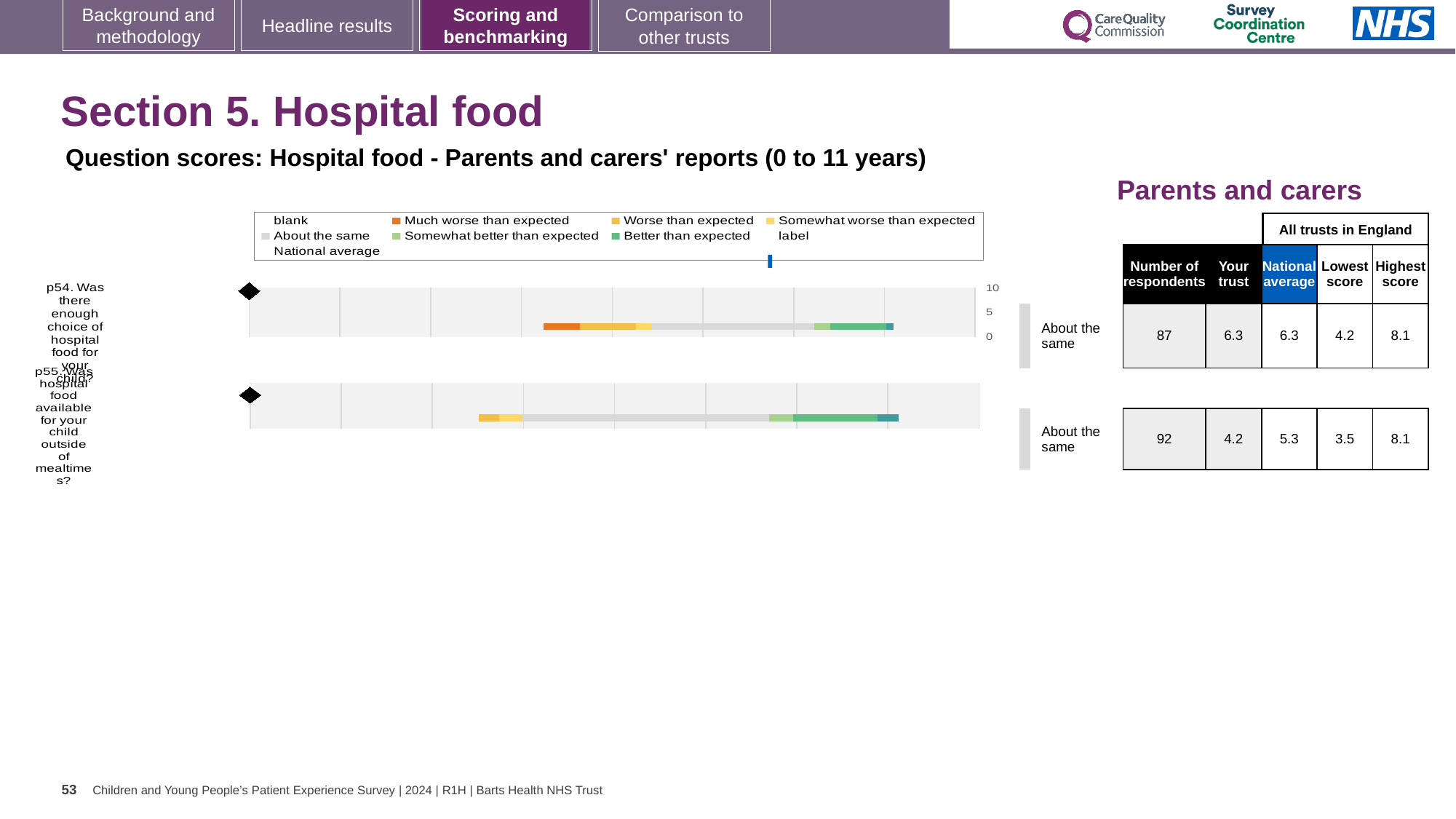
What kind of chart is used to show the question scores for hospital food? bar chart What is the difference between the highest and lowest scores for p54 (enough choice of hospital food)? 3.9 In the hospital food chart, which legend entry is shown in orange? Much worse than expected How many more respondents answered p55 than p54? 5 Which of the two questions has the lower 'Your trust' score? p55 (hospital food available outside of mealtimes) For p55, which is larger: the 'Your trust' score or the national average? National average What is the lowest score among all trusts in England for p55 (hospital food available outside of mealtimes)? 3.5 In the hospital food chart, which legend entry is shown in light grey? About the same How many questions (categories) are plotted in the hospital food chart? 2 What is the national average score for p54 (enough choice of hospital food)? 6.3 What is the number of respondents for p54 (enough choice of hospital food)? 87 What is the 'Your trust' score for p55 (hospital food available outside of mealtimes)? 4.2